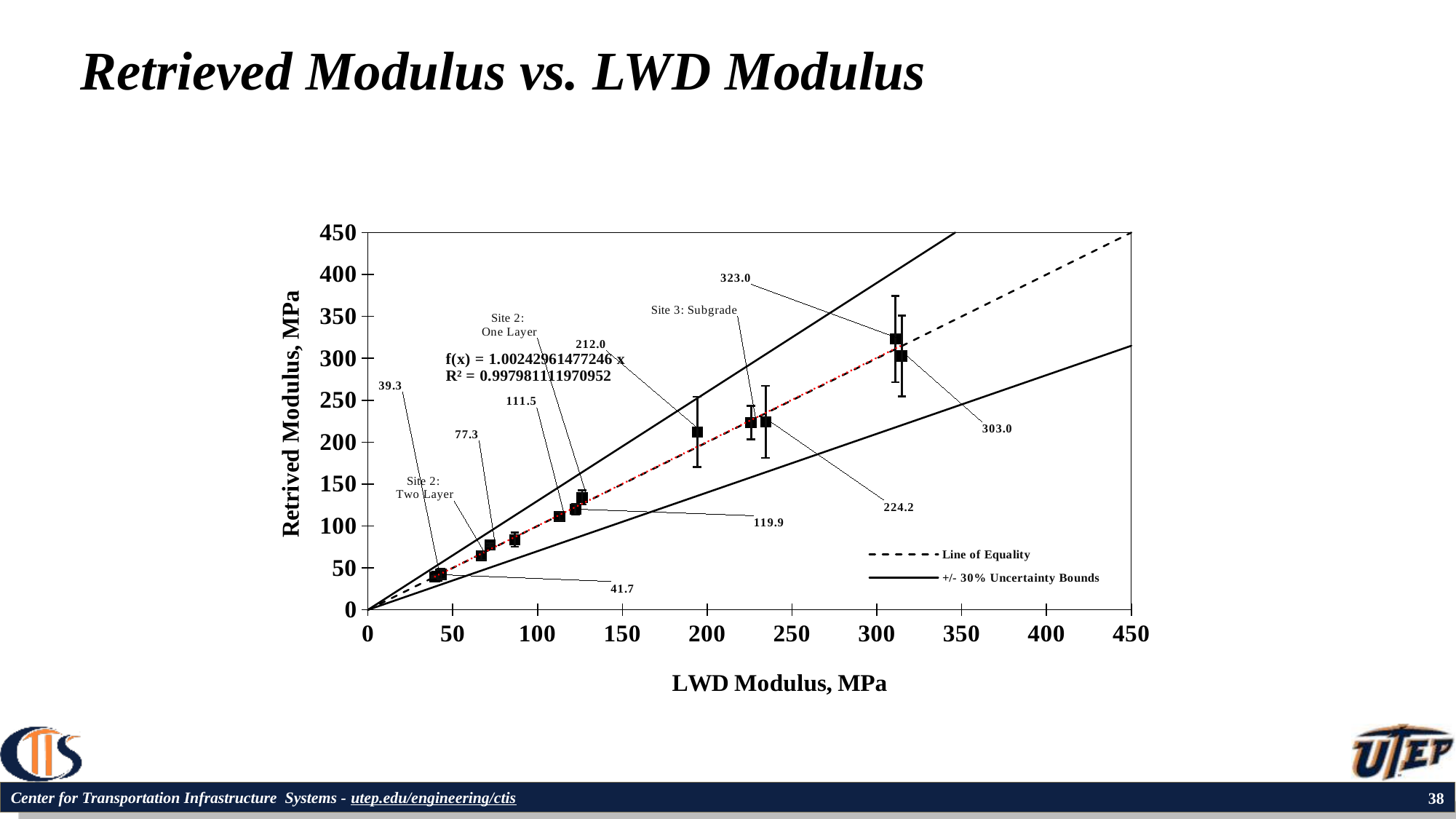
How many entries does the legend list? 2 What R² value is printed on the chart? 0.997981111970952 What is the title of the slide's chart? Retrieved Modulus vs. LWD Modulus What is the difference between the data labels 224.2 and 212.0? 12.2 What kind of chart is shown on the slide? Scatter chart What is the label of the x axis? LWD Modulus, MPa What is the smallest data label value printed on the chart? 39.3 What is the largest data label value printed on the chart? 323.0 Which labeled value is larger, 119.9 or 111.5? 119.9 Is the LWD Modulus of the point labeled 323.0 greater or less than 250? greater Do the retrieved modulus values rise or fall as LWD modulus increases along the x axis? rise What is the difference between the largest labeled value (323.0) and the smallest labeled value (39.3)? 283.7